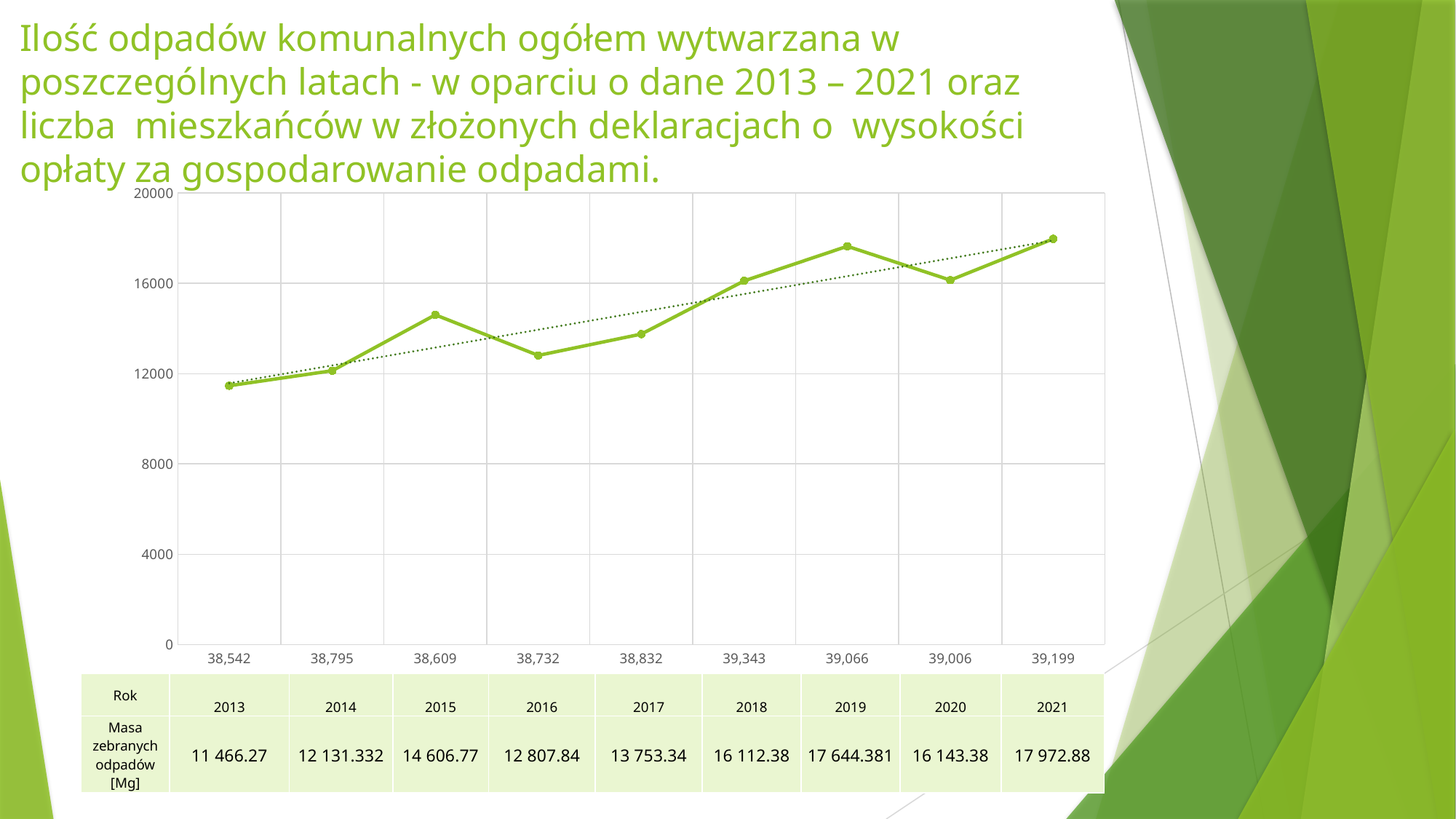
Do the values generally rise or fall from 2013 to 2021? rise Is the value for 2020 greater or less than 16000? greater Which year has a larger mass of collected waste, 2015 or 2016? 2015 Which year has the lowest mass of collected waste? 2013 What is the mass of collected waste [Mg] for 2016? 12 807.84 How many years (data points) are plotted on the chart? 9 What is the difference between the mass of collected waste in 2018 and in 2017? 2 359.04 What is the mass of collected waste [Mg] for 2019? 17 644.381 What is the mass of collected waste [Mg] for 2013? 11 466.27 What number of residents is shown on the x axis for the year 2018? 39,343 What kind of chart is shown on the slide? line chart Which year has the highest mass of collected waste? 2021